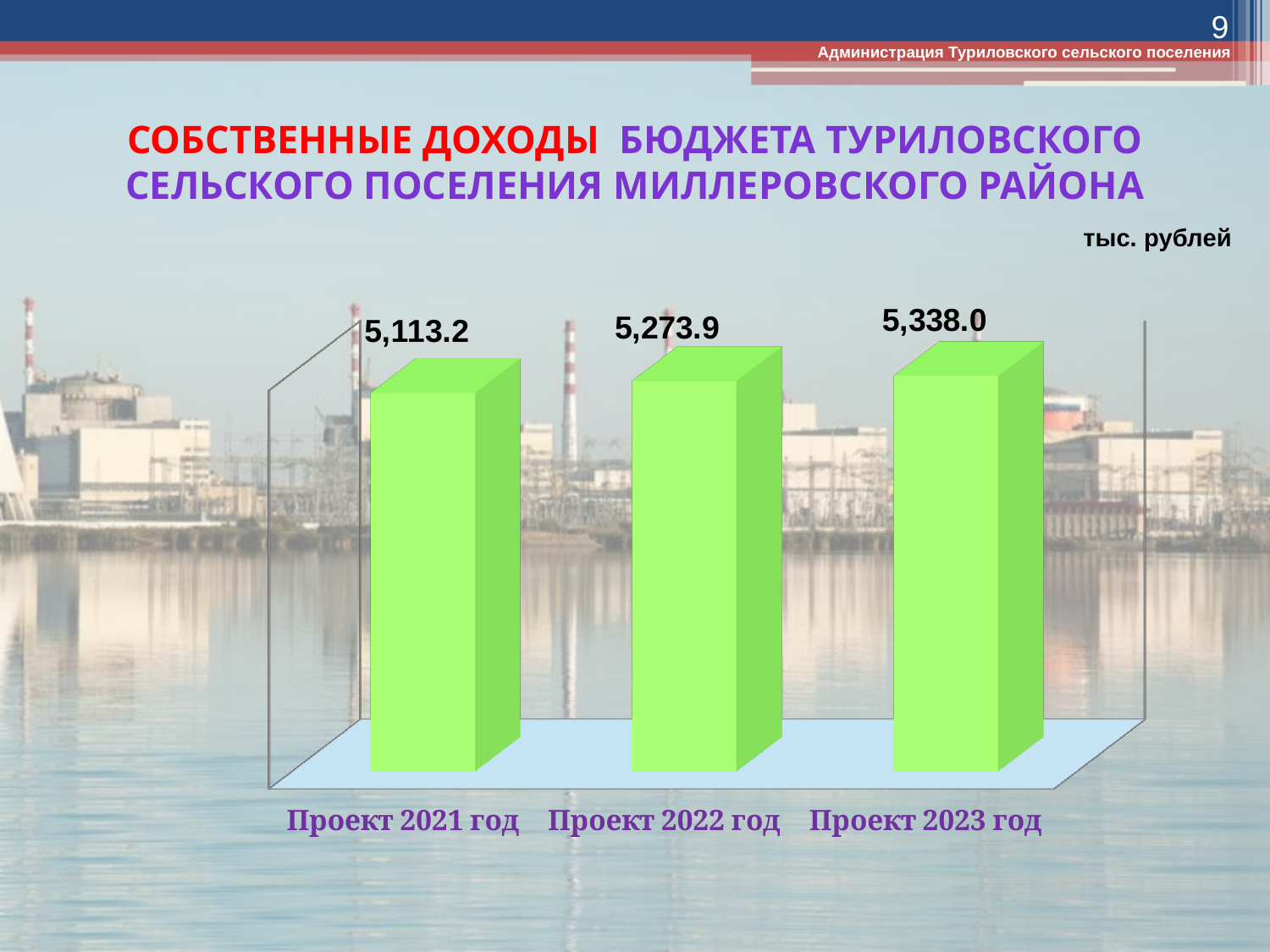
Do the values rise or fall from Проект 2021 год to Проект 2023 год? Rise What type of chart is shown on the slide? Bar chart What is the value shown for Проект 2021 год? 5,113.2 What is the difference between the values for Проект 2023 год and Проект 2021 год? 224.8 What is the value shown for Проект 2022 год? 5,273.9 Which year has the lowest value on the chart? Проект 2021 год How many bars are shown on the chart? 3 What is the difference between the values for Проект 2022 год and Проект 2021 год? 160.7 What is the difference between the values for Проект 2023 год and Проект 2022 год? 64.1 Which is larger, the value for Проект 2021 год or the value for Проект 2023 год? Проект 2023 год What is the value shown for Проект 2023 год? 5,338.0 Which year has the highest value on the chart? Проект 2023 год